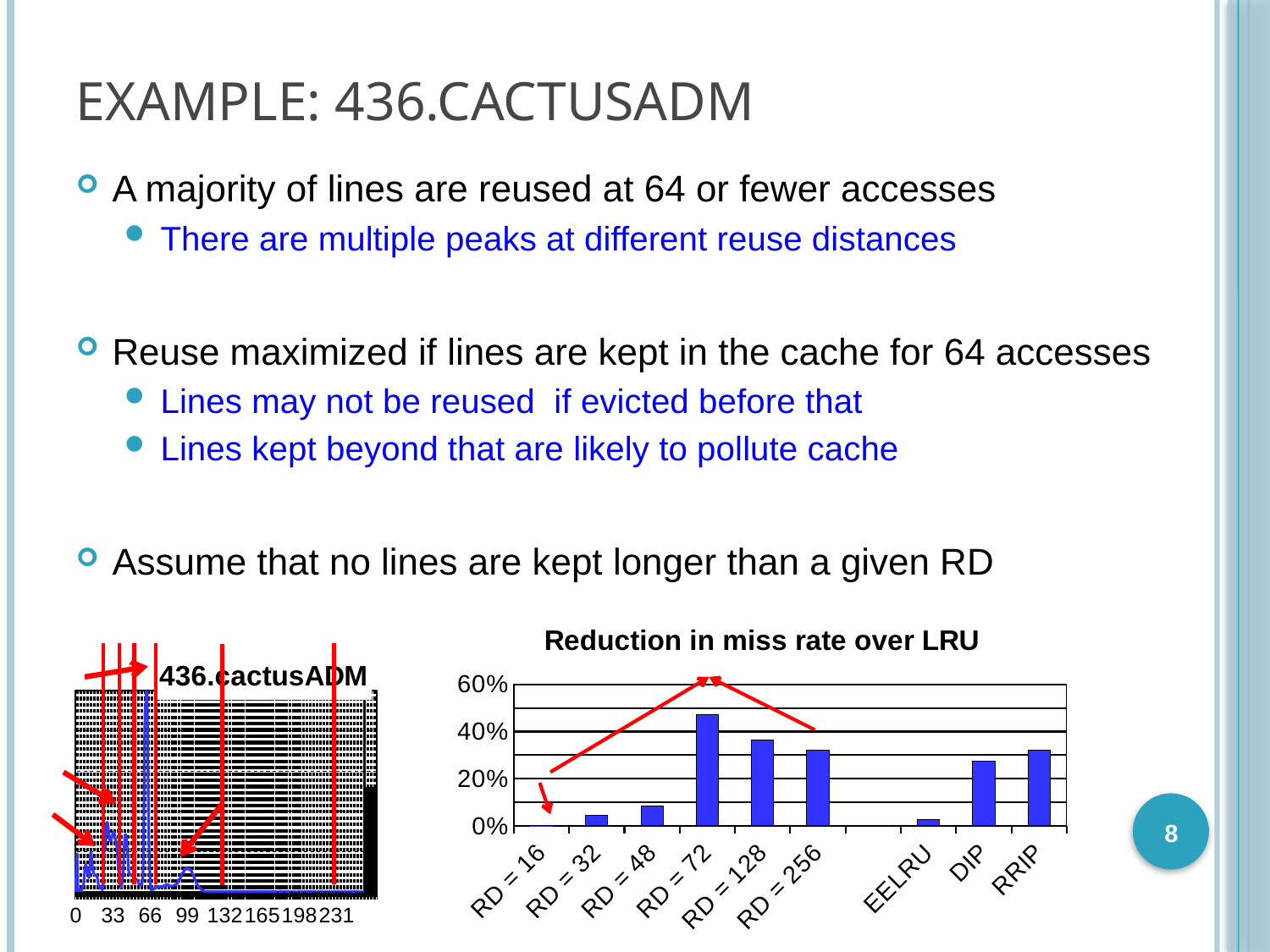
On the 'Reduction in miss rate over LRU' chart, which is larger, the value for RD = 72 or the value for RD = 128? RD = 72 On the 'Reduction in miss rate over LRU' chart, is the value for EELRU greater or less than 20%? less On the 'Reduction in miss rate over LRU' chart, is the value for RD = 72 greater or less than 40%? greater What is the title of the bar chart on the right of the slide? Reduction in miss rate over LRU On the 'Reduction in miss rate over LRU' chart, is the value for DIP greater or less than 20%? greater On the 'Reduction in miss rate over LRU' chart, what kind of chart is shown? bar chart On the 'Reduction in miss rate over LRU' chart, which category has the highest reduction in miss rate? RD = 72 On the 'Reduction in miss rate over LRU' chart, how many categories are plotted along the x axis? 9 What is the title of the chart on the bottom left of the slide? 436.cactusADM On the 'Reduction in miss rate over LRU' chart, which is larger, the value for DIP or the value for RD = 48? DIP